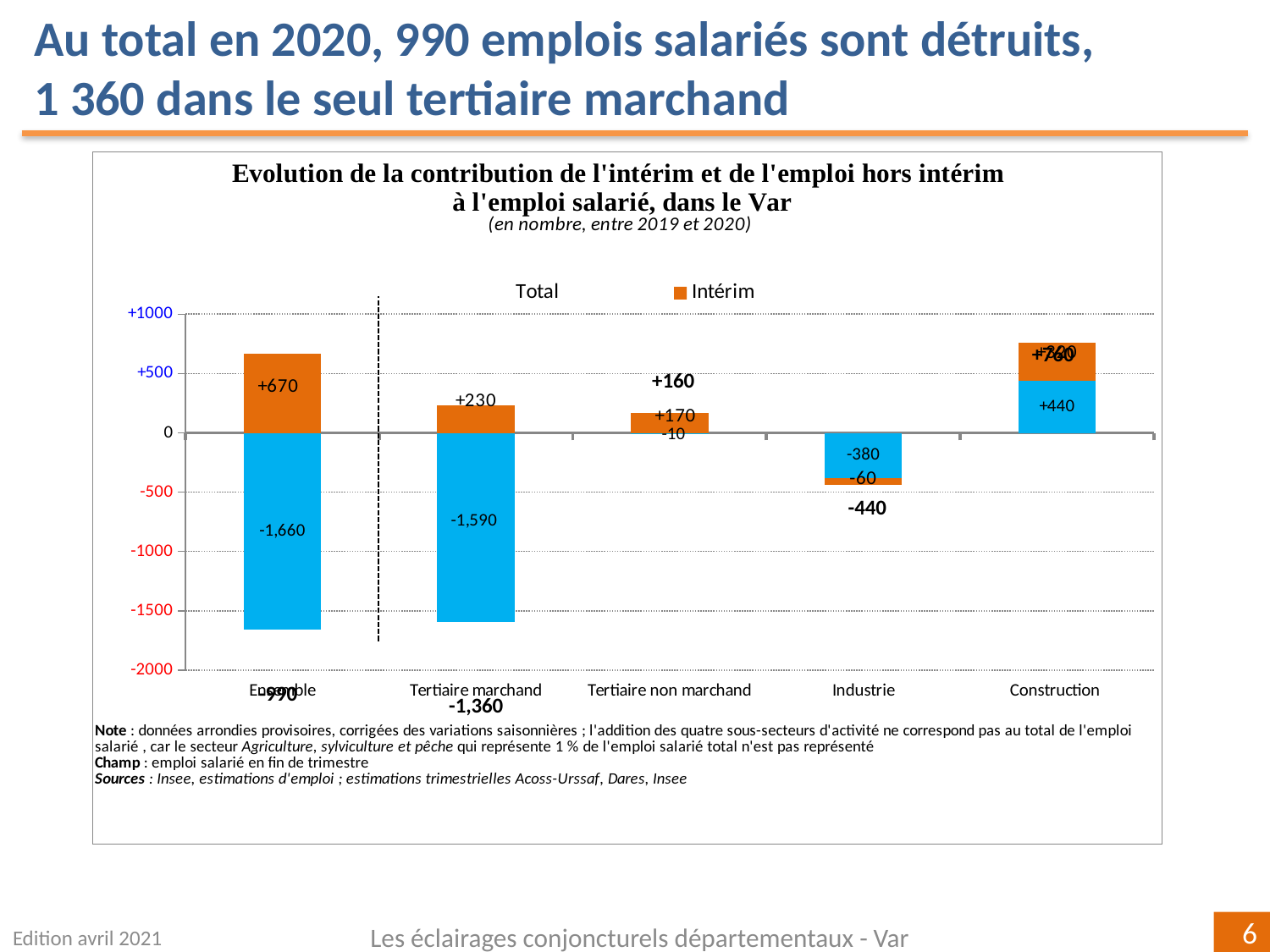
What is the value of the blue bar for Tertiaire marchand? -1,590 What is the Intérim value for Tertiaire marchand? +230 What is the value of the blue bar for Industrie? -380 What kind of chart is shown on the slide? bar chart How many sector categories are shown along the x axis of the chart? 5 What is the total value shown for Tertiaire marchand? -1,360 What is the Intérim value for Ensemble? +670 What is the value of the blue bar for Construction? +440 What is the Intérim value for Industrie? -60 What is the difference between the Intérim value for Ensemble and the Intérim value for Tertiaire marchand? 440 What is the Intérim value for Tertiaire non marchand? +170 Which category has the lowest blue bar value? Ensemble